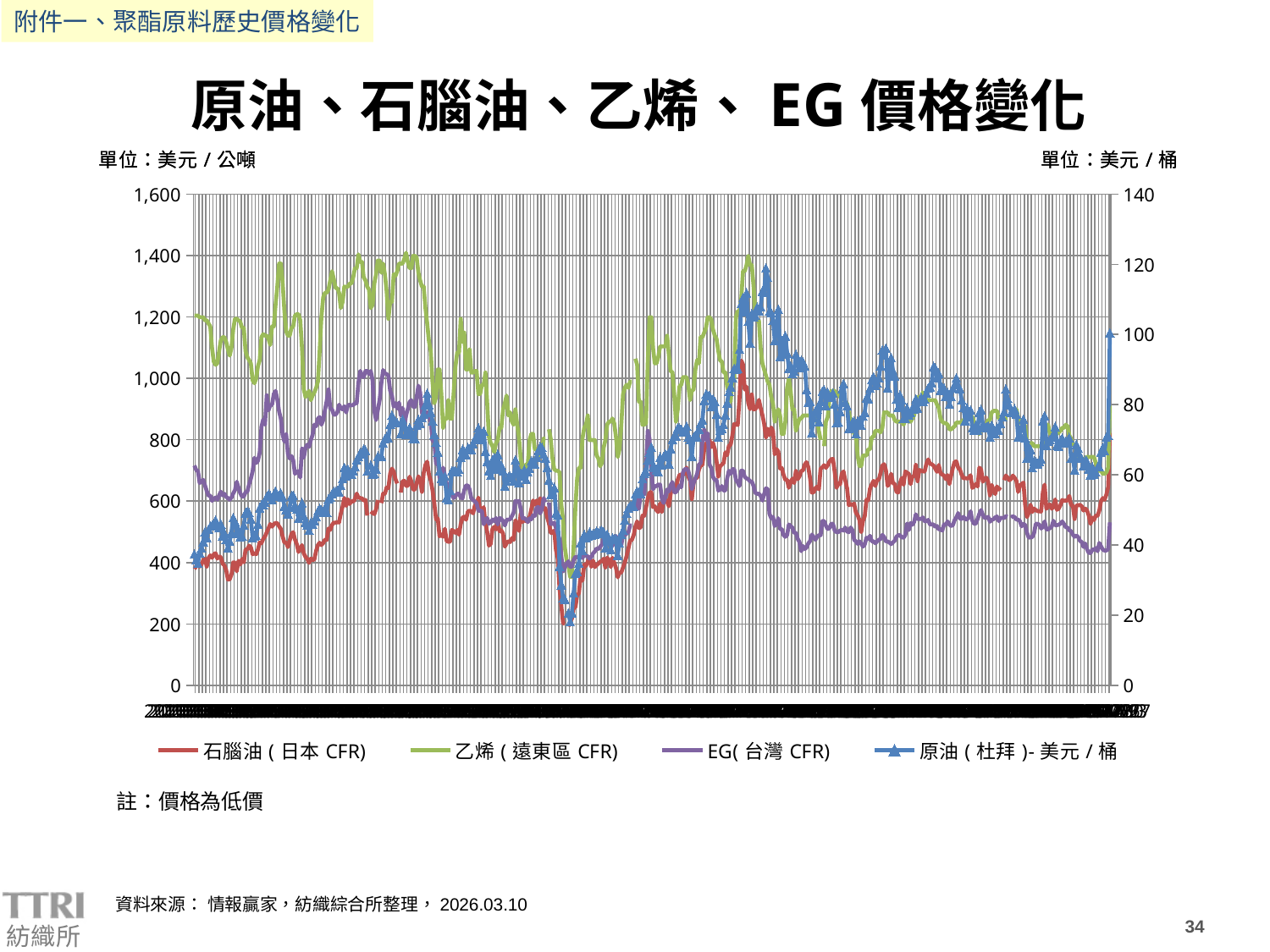
What is the maximum value shown on the left vertical axis? 1,600 What is the maximum value shown on the right vertical axis? 140 What kind of chart is shown on the slide? line chart Is the lowest value reached by the 石腦油 ( 日本 CFR) series greater or less than 600? less Is the highest value reached by the 乙烯 ( 遠東區 CFR) series greater or less than 1,200? greater Is the highest value reached by the 石腦油 ( 日本 CFR) series greater or less than 1,200? less Which series is plotted with triangle markers? 原油 ( 杜拜 )- 美元 / 桶 Which series reaches the highest value on the left axis, 乙烯 ( 遠東區 CFR) or 石腦油 ( 日本 CFR)? 乙烯 ( 遠東區 CFR) What is the title of the chart? 原油、石腦油、乙烯、 EG 價格變化 How many series does the legend list? 4